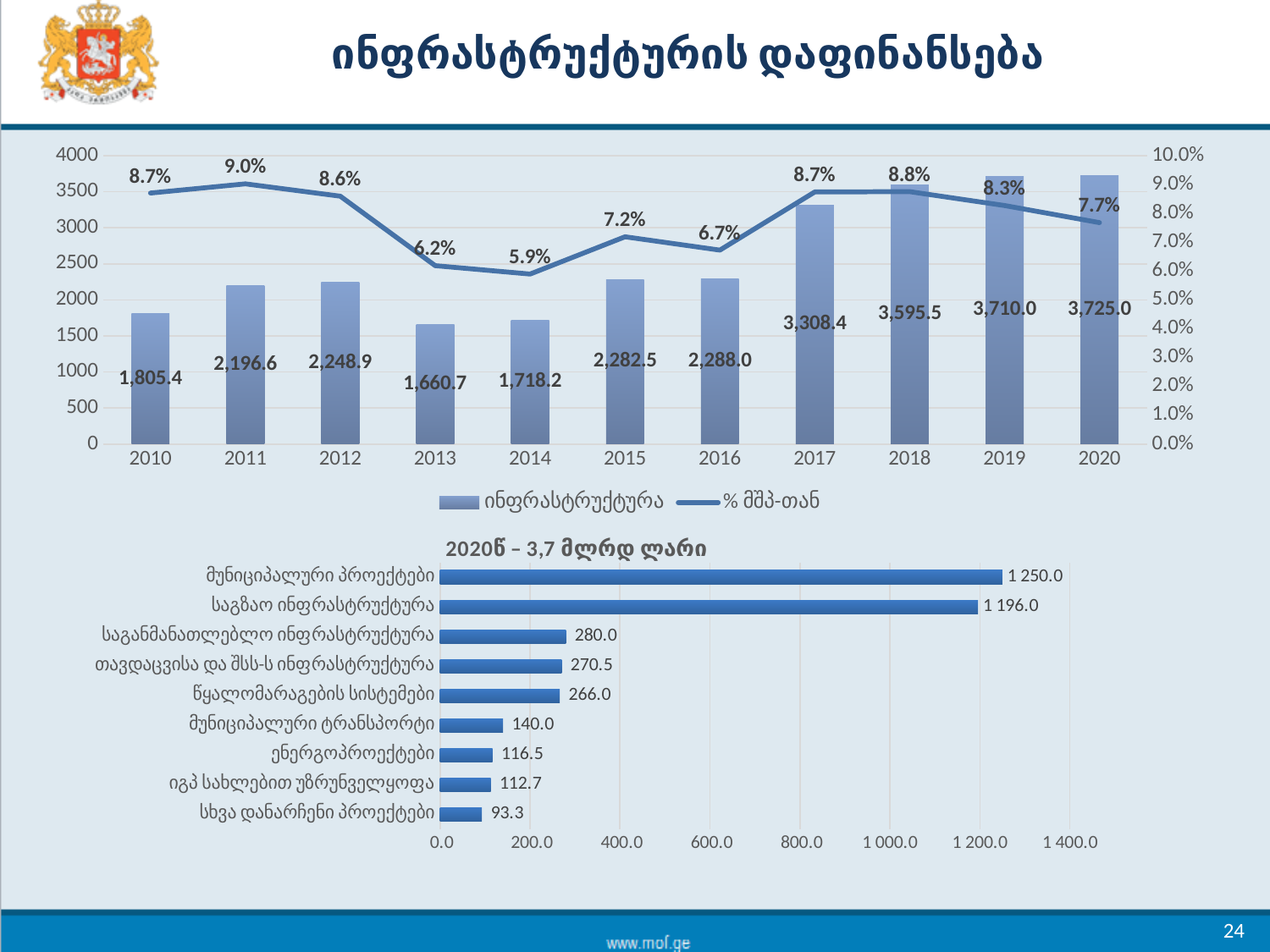
In the bottom chart, which category has the lowest value? სხვა დანარჩენი პროექტები In the top chart, which year has the highest % მშპ-თან value? 2011 How many series does the legend of the top chart list? 2 How many years are shown on the x axis of the top chart? 11 In the bottom chart, what is the difference between მუნიციპალური პროექტები and საგზაო ინფრასტრუქტურა? 54.0 In the bottom chart, what is the value for საგზაო ინფრასტრუქტურა? 1 196.0 What type of chart is the bottom chart? Bar chart In the top chart, what is the difference between the ინფრასტრუქტურა values for 2020 and 2019? 15.0 In the top chart, what is the % მშპ-თან value for 2014? 5.9% In the top chart, which year has the highest ინფრასტრუქტურა bar? 2020 In the top chart, which year has the lowest ინფრასტრუქტურა bar? 2013 In the top chart, what is the value of the ინფრასტრუქტურა bar for 2017? 3,308.4